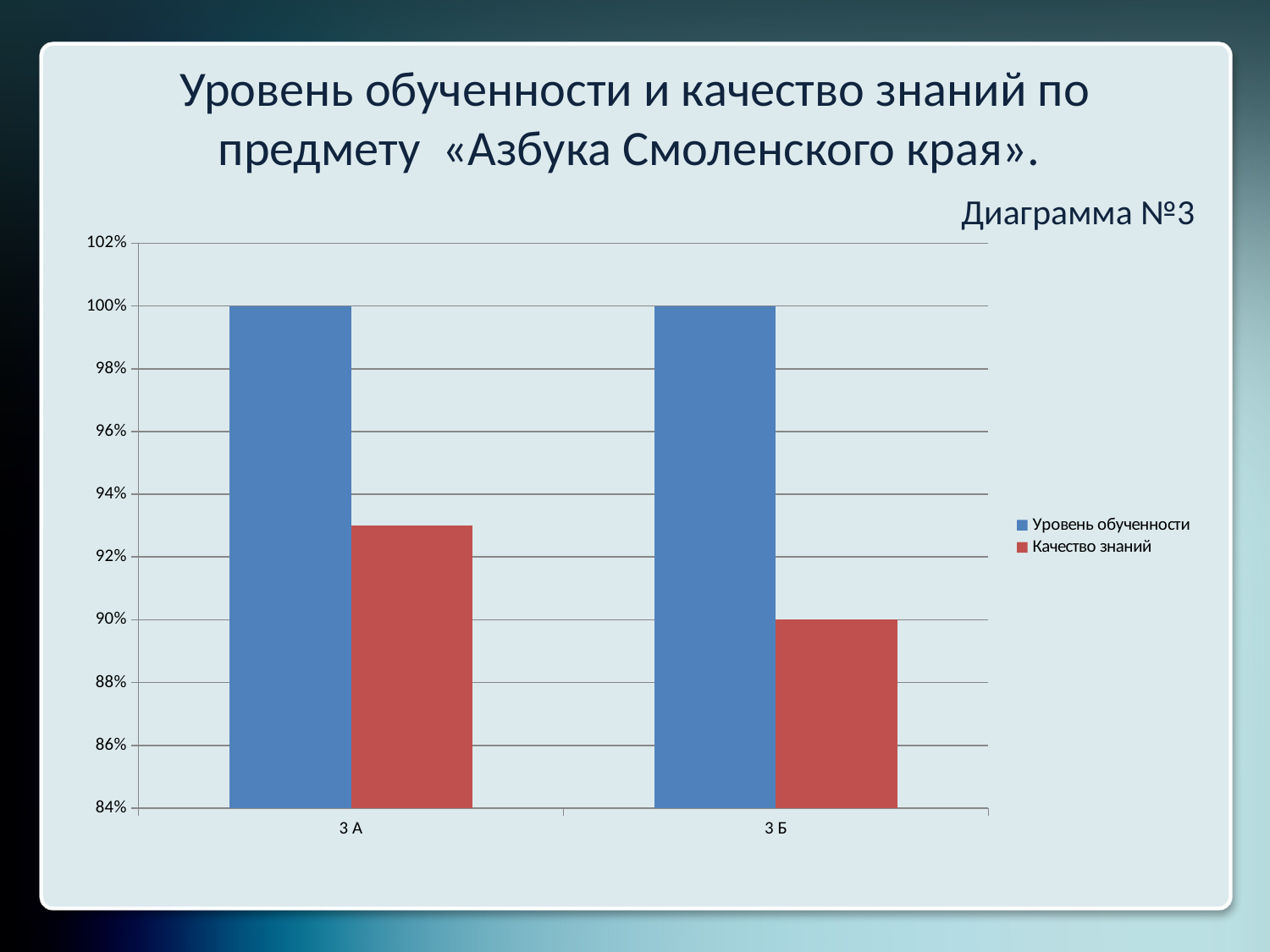
How many categories are shown on the x axis? 2 What is the difference between Уровень обученности and Качество знаний for 3 Б? 10% What is the value of Уровень обученности for 3 А? 100% What is the value of Уровень обученности for 3 Б? 100% What colour represents Качество знаний in the legend? red What kind of chart is shown on the slide? bar chart Is the value of Качество знаний for 3 А greater or less than 92%? greater Is the value of Качество знаний for 3 А greater or less than 94%? less Which category has the lowest Качество знаний? 3 Б Which class has the higher Качество знаний, 3 А or 3 Б? 3 А How many series does the legend list? 2 What is the value of Качество знаний for 3 Б? 90%